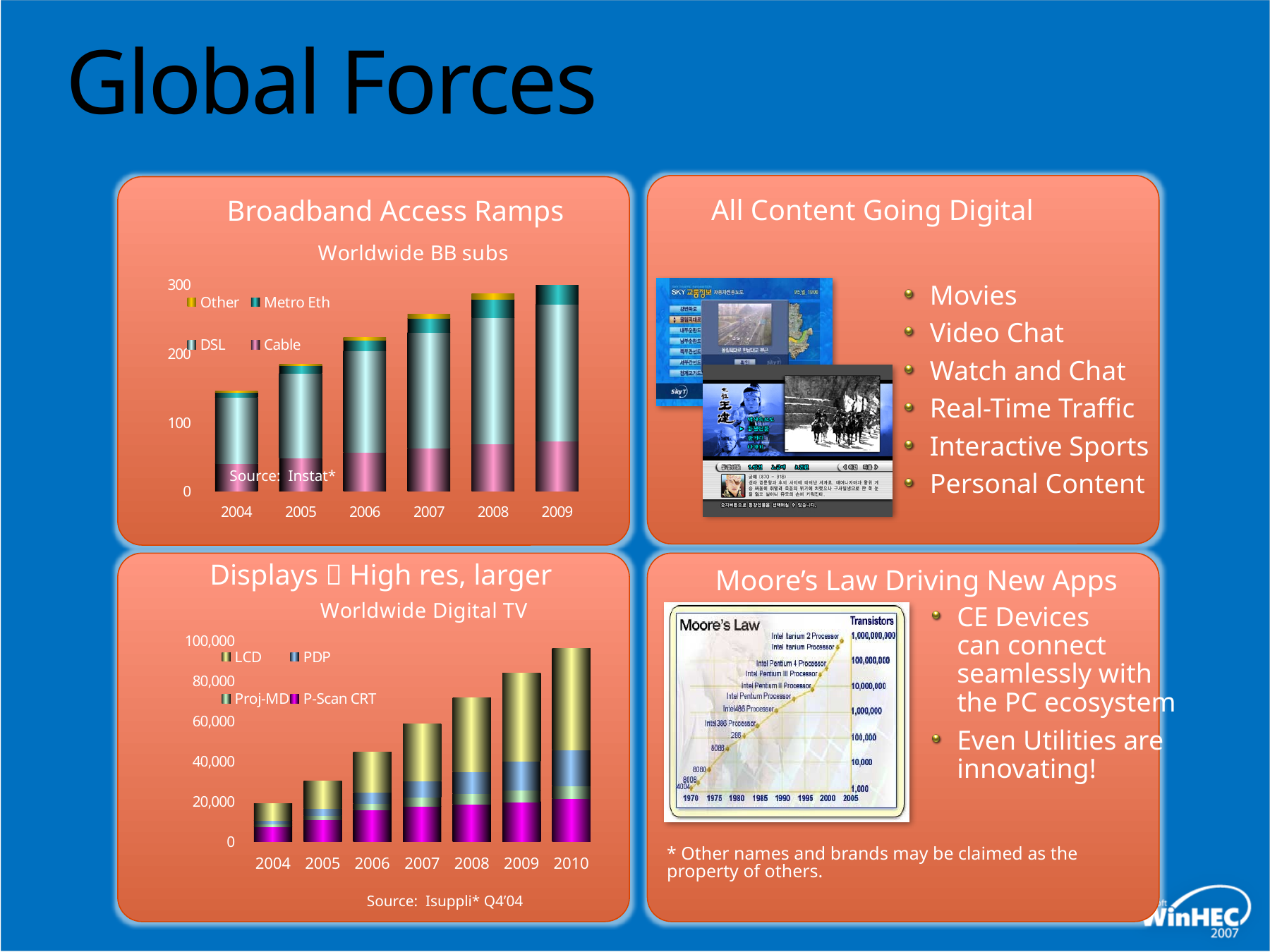
How many years are shown on the x axis of the Worldwide Digital TV chart? 7 Do the stacked bar totals in the Worldwide BB subs chart rise or fall from 2004 to 2009? Rise In the Worldwide BB subs chart, which year has the shortest stacked bar? 2004 What kind of chart is the Worldwide BB subs chart? Stacked bar chart What kind of chart is the Worldwide Digital TV chart? Stacked bar chart In the Worldwide BB subs chart, which year has the tallest stacked bar? 2009 How many years are shown on the x axis of the Worldwide BB subs chart? 6 How many series does the legend of the Worldwide BB subs chart list? 4 What source is cited below the Worldwide Digital TV chart? Isuppli* Q4'04 In the Worldwide Digital TV chart, is the total for 2010 greater or less than 80,000? greater In the Worldwide BB subs chart, is the total for 2004 greater or less than 100? greater In the Worldwide BB subs chart, is the total for 2005 greater or less than 200? less